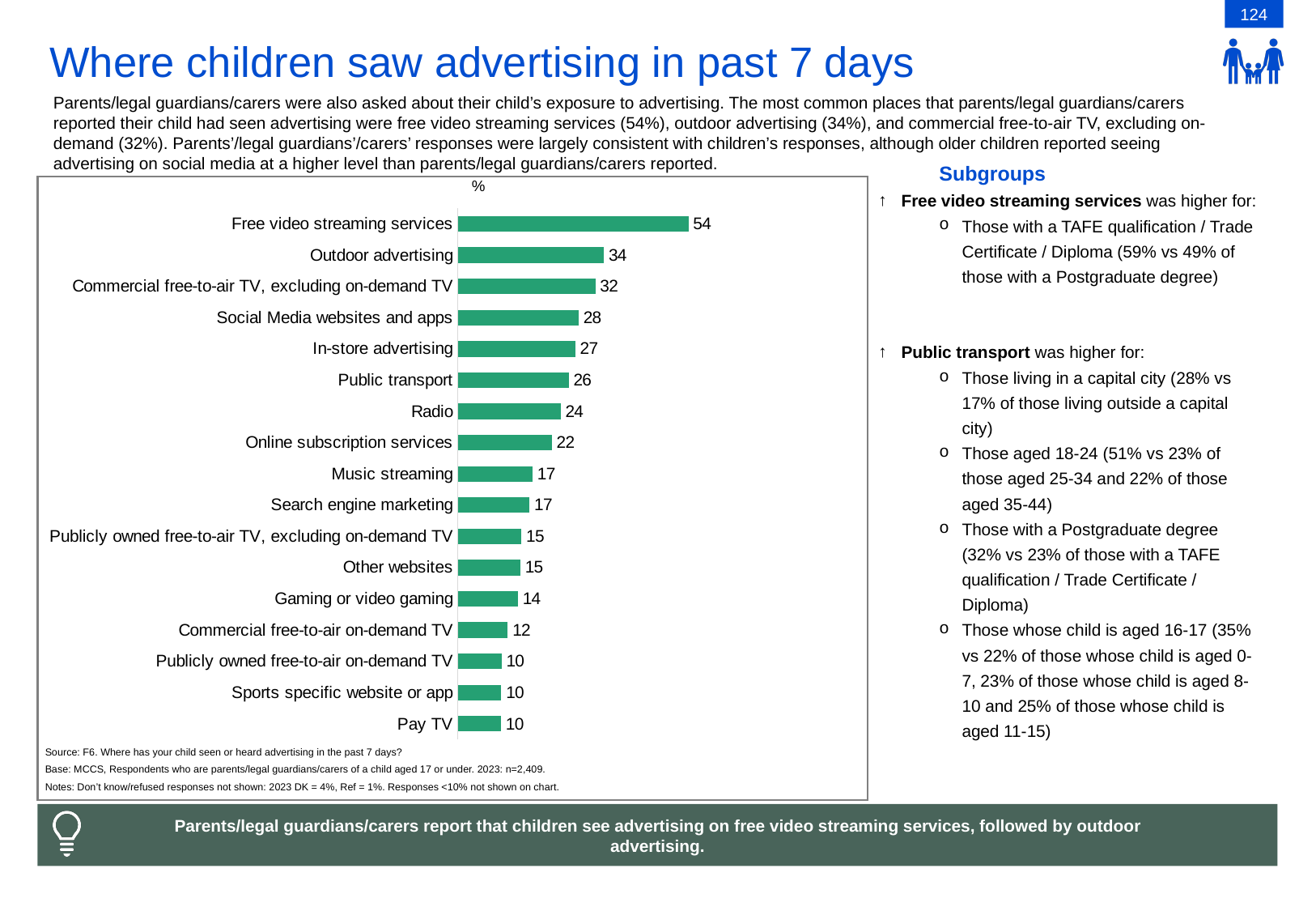
What is the value for Radio? 24 What is the value for Free video streaming services? 54 How many categories are shown in the chart? 17 Which is larger, the value for Social Media websites and apps or the value for Online subscription services? Social Media websites and apps Which category has the highest value? Free video streaming services Which is larger, the value for In-store advertising or the value for Music streaming? In-store advertising What is the value for Gaming or video gaming? 14 What is the value for Commercial free-to-air on-demand TV? 12 What is the value for Public transport? 26 What is the difference between the values for Free video streaming services and Pay TV? 44 What kind of chart is shown on the slide? Bar chart What is the difference between the values for Outdoor advertising and Commercial free-to-air TV, excluding on-demand TV? 2